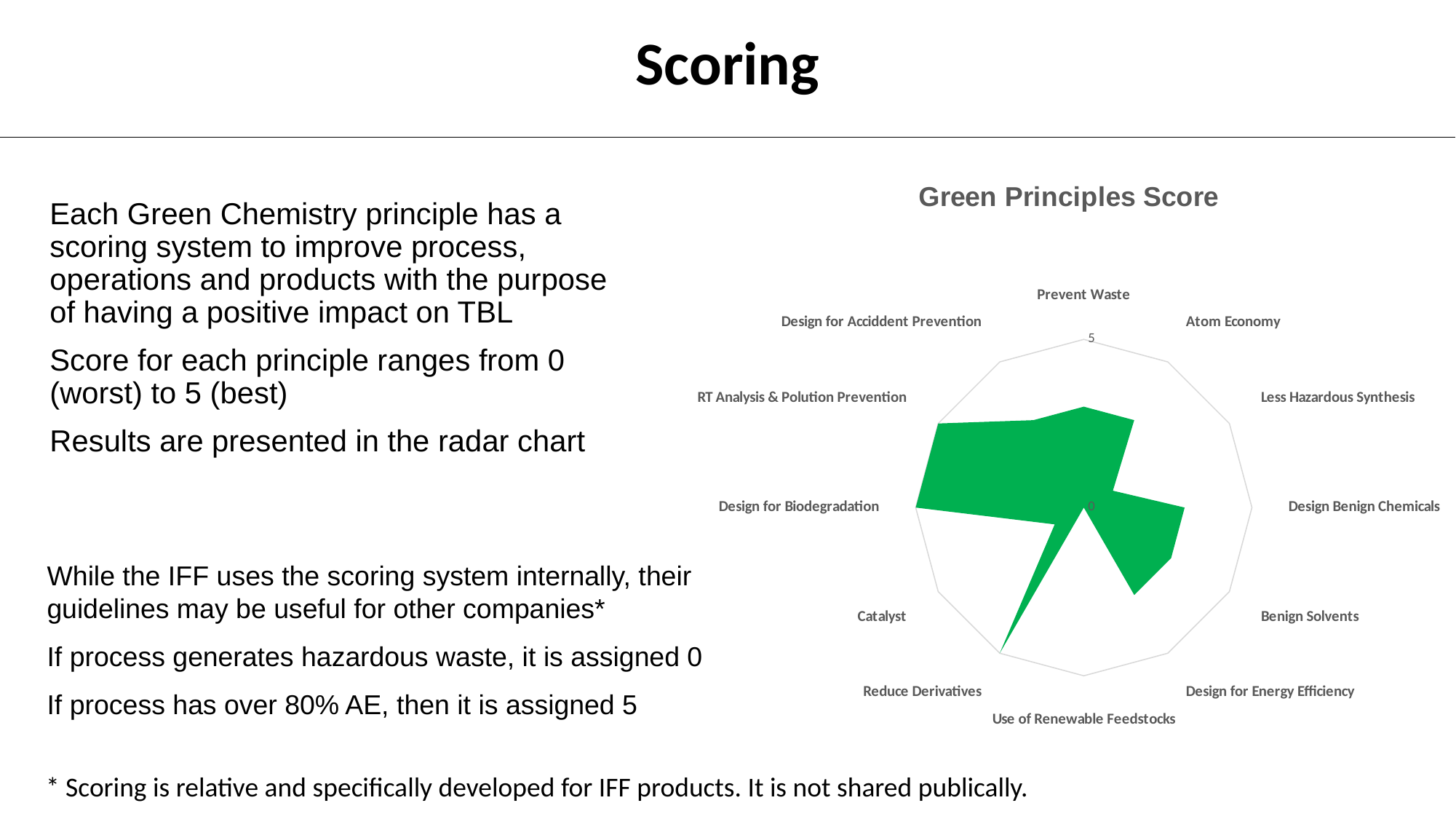
What score is plotted for Use of Renewable Feedstocks? 0 What score does Design for Biodegradation reach on the radar chart? 5 What is the maximum value shown on the radar chart's axis? 5 What is the title of the chart? Green Principles Score Which has the higher score, Design for Biodegradation or Atom Economy? Design for Biodegradation What score does Reduce Derivatives reach on the radar chart? 5 Which has the higher score, Prevent Waste or Less Hazardous Synthesis? Prevent Waste What type of chart is shown on the slide? Radar chart Which has the higher score, Design Benign Chemicals or Catalyst? Design Benign Chemicals How many principles (categories) are plotted on the radar chart? 12